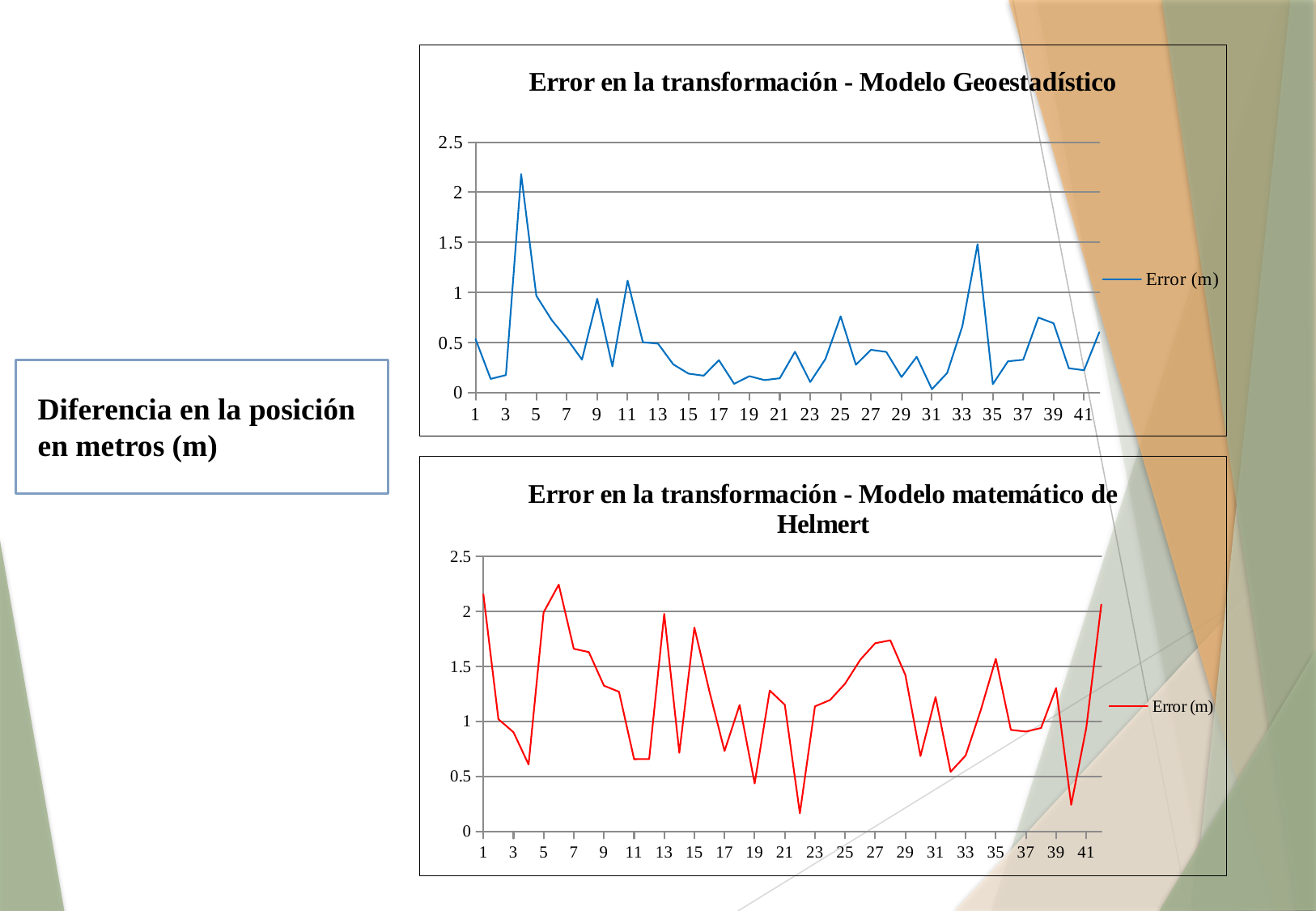
In the 'Modelo Geoestadístico' chart, at which x-axis point is the error lowest? 31 In the 'Modelo Geoestadístico' chart, is the value at point 34 greater or less than 1? greater In the 'Modelo Geoestadístico' chart, which is larger, the value at point 4 or the value at point 34? point 4 In the 'Modelo Geoestadístico' chart, how many series does the legend list? 1 What kind of chart is the 'Error en la transformación - Modelo Geoestadístico' chart? line chart In the 'Modelo Geoestadístico' chart, at which x-axis point is the error highest? 4 In the 'Modelo matemático de Helmert' chart, at which x-axis point is the error lowest? 22 In the 'Modelo matemático de Helmert' chart, is the value at point 13 greater or less than 1.5? greater In the 'Modelo Geoestadístico' chart, is the value at point 4 greater or less than 2? greater In the 'Modelo matemático de Helmert' chart, what is the legend entry for the plotted series? Error (m) What kind of chart is the 'Error en la transformación - Modelo matemático de Helmert' chart? line chart